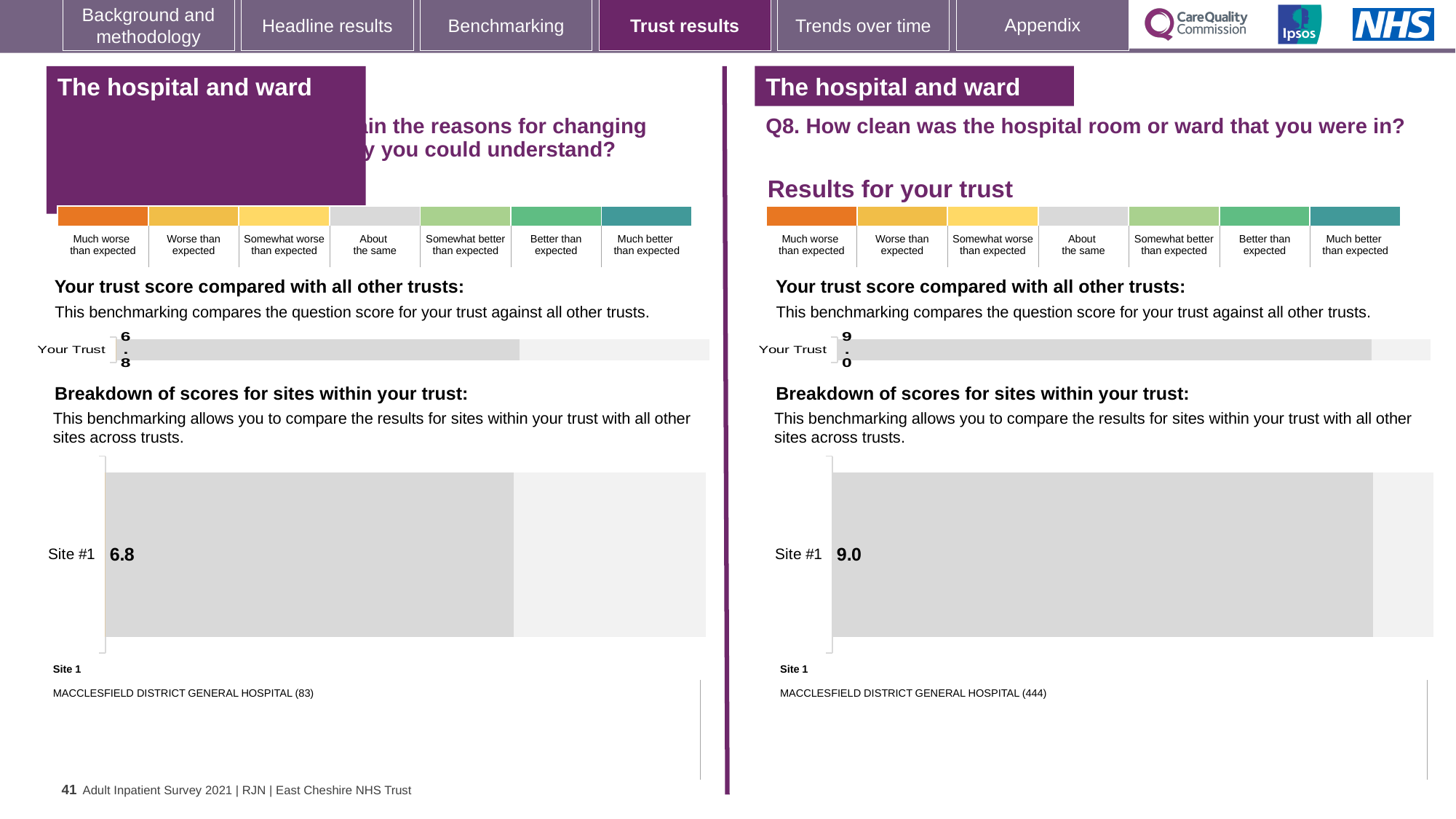
On the left-hand side of the slide, which hospital is listed as Site 1? MACCLESFIELD DISTRICT GENERAL HOSPITAL (83) What is the difference between the Site #1 score for Q8 on the right-hand side and the Site #1 score on the left-hand side of the slide? 2.2 On the left-hand side of the slide, what is the score shown for Your Trust? 6.8 On the right-hand side of the slide (Q8), which hospital is listed as Site 1? MACCLESFIELD DISTRICT GENERAL HOSPITAL (444) On the left-hand side of the slide, what is the score shown for Site #1 in the breakdown of scores for sites within your trust? 6.8 What kind of chart is used to show the Site #1 score on the right-hand side of the slide? Bar chart Which is larger: the Your Trust score on the left-hand side of the slide or the Your Trust score for Q8 on the right-hand side? Q8 on the right-hand side On the right-hand side of the slide (Q8), is the Your Trust score the same as the Site #1 score? Yes How many sites are shown in the breakdown of scores for sites within your trust on the right-hand side of the slide (Q8)? 1 On the right-hand side of the slide (Q8), what is the score shown for Site #1 in the breakdown of scores for sites within your trust? 9.0 On the right-hand side of the slide (Q8, how clean was the hospital room or ward), what is the score shown for Your Trust? 9.0